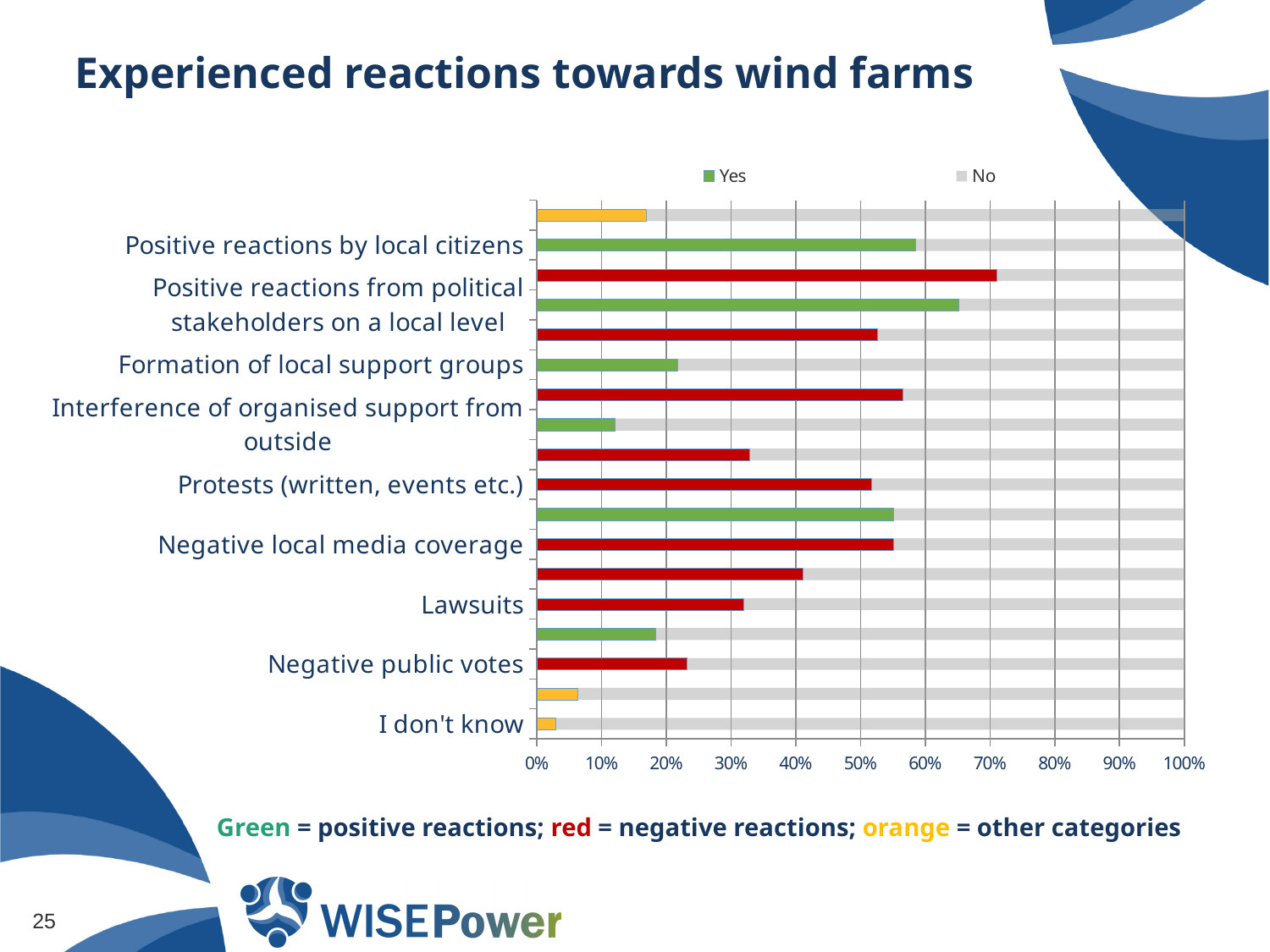
How many series does the legend list? 2 Is the value for 'Negative public votes' greater or less than 30%? less Is the value for 'Negative local media coverage' greater or less than 50%? greater How many category labels are shown on the vertical axis of the chart? 9 Which is larger: the value for 'Positive reactions from political stakeholders on a local level' or for 'Positive reactions by local citizens'? Positive reactions from political stakeholders on a local level According to the note below the chart, what do the red bars represent? negative reactions Is the value for 'I don't know' greater or less than 10%? less Which is larger: the value for 'Formation of local support groups' or for 'Interference of organised support from outside'? Formation of local support groups What kind of chart is shown on the slide? bar chart What are the two entries in the chart legend? Yes and No